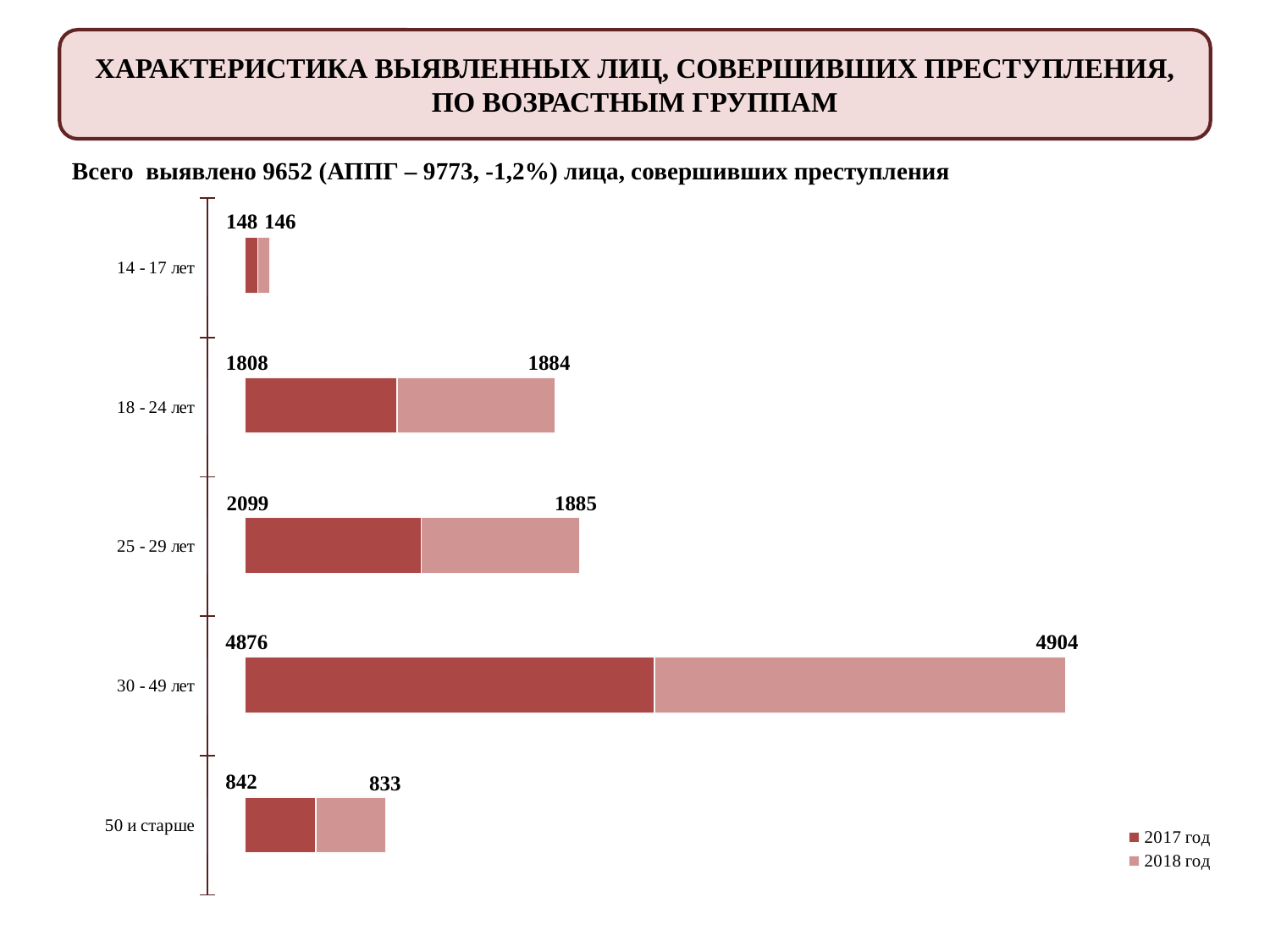
What is the value for the 2017 год series in the 25 - 29 лет age group? 2099 How many series does the legend list? 2 How many age groups are shown on the chart? 5 What is the total of the stacked bar for the 50 и старше age group? 1675 What kind of chart is shown on the slide? Stacked bar chart Which is larger for the 18 - 24 лет age group: the 2017 год value or the 2018 год value? 2018 год Which age group has the lowest value for 2017 год? 14 - 17 лет Which age group has the highest value for 2018 год? 30 - 49 лет What are the two series listed in the legend? 2017 год and 2018 год What is the value for the 2017 год series in the 30 - 49 лет age group? 4876 What is the difference between the 2017 год and 2018 год values for the 25 - 29 лет age group? 214 What is the value for the 2018 год series in the 18 - 24 лет age group? 1884